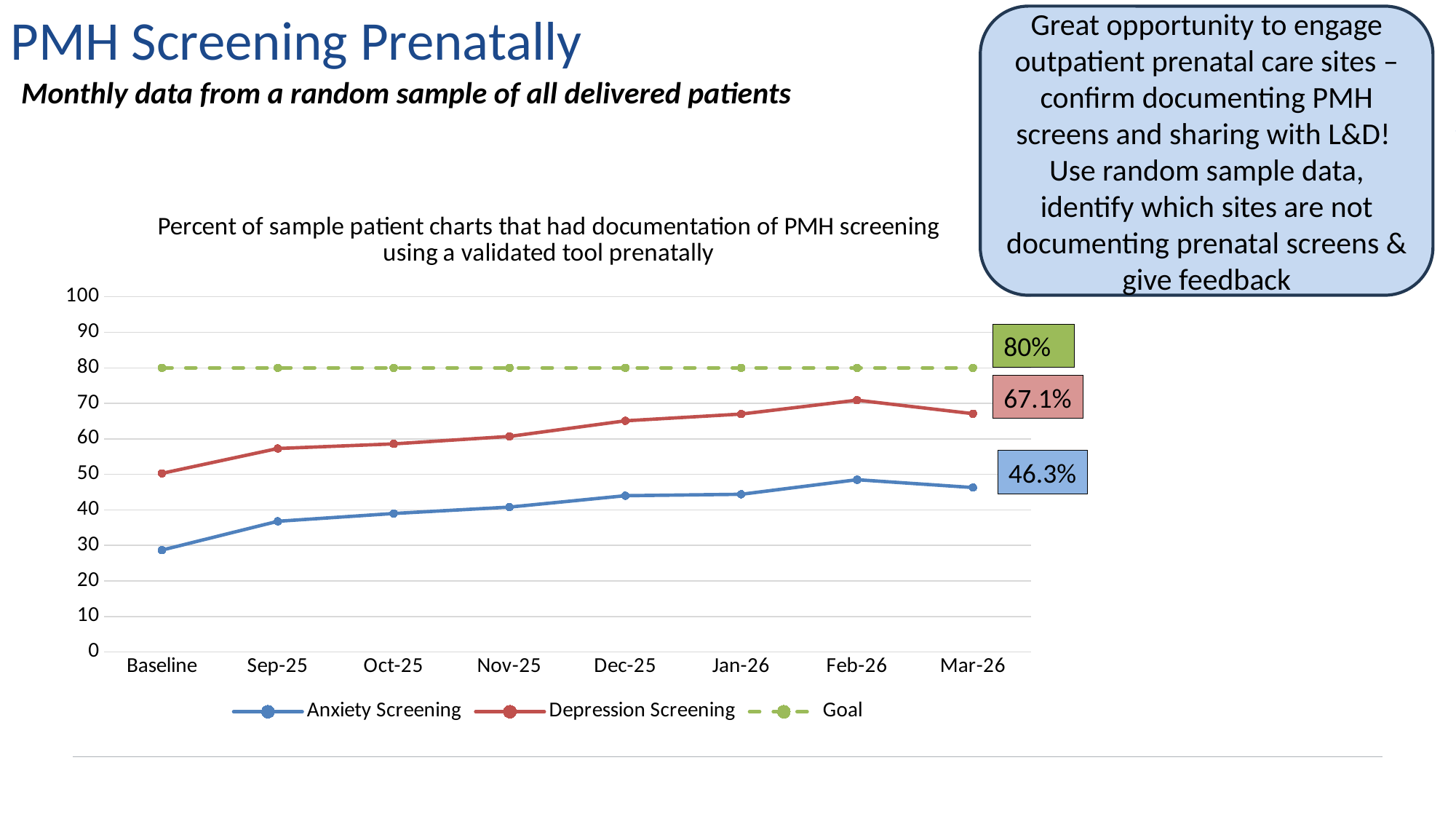
What kind of chart is shown on the slide? line chart What is the Anxiety Screening value for Mar-26? 46.3% How many points are on the x axis of the chart? 8 What is the Depression Screening value for Mar-26? 67.1% How many series does the chart legend list? 3 What is the difference between the Depression Screening and Anxiety Screening values for Mar-26? 20.8% Is the Anxiety Screening value for Baseline greater or less than 40? less At which x-axis point is the Depression Screening value highest? Feb-26 What value is the Goal line set at? 80% Do the Anxiety Screening values rise or fall from Baseline to Feb-26? rise Is the Depression Screening value for Feb-26 greater or less than 60? greater Which is larger at Mar-26, Depression Screening or Anxiety Screening? Depression Screening